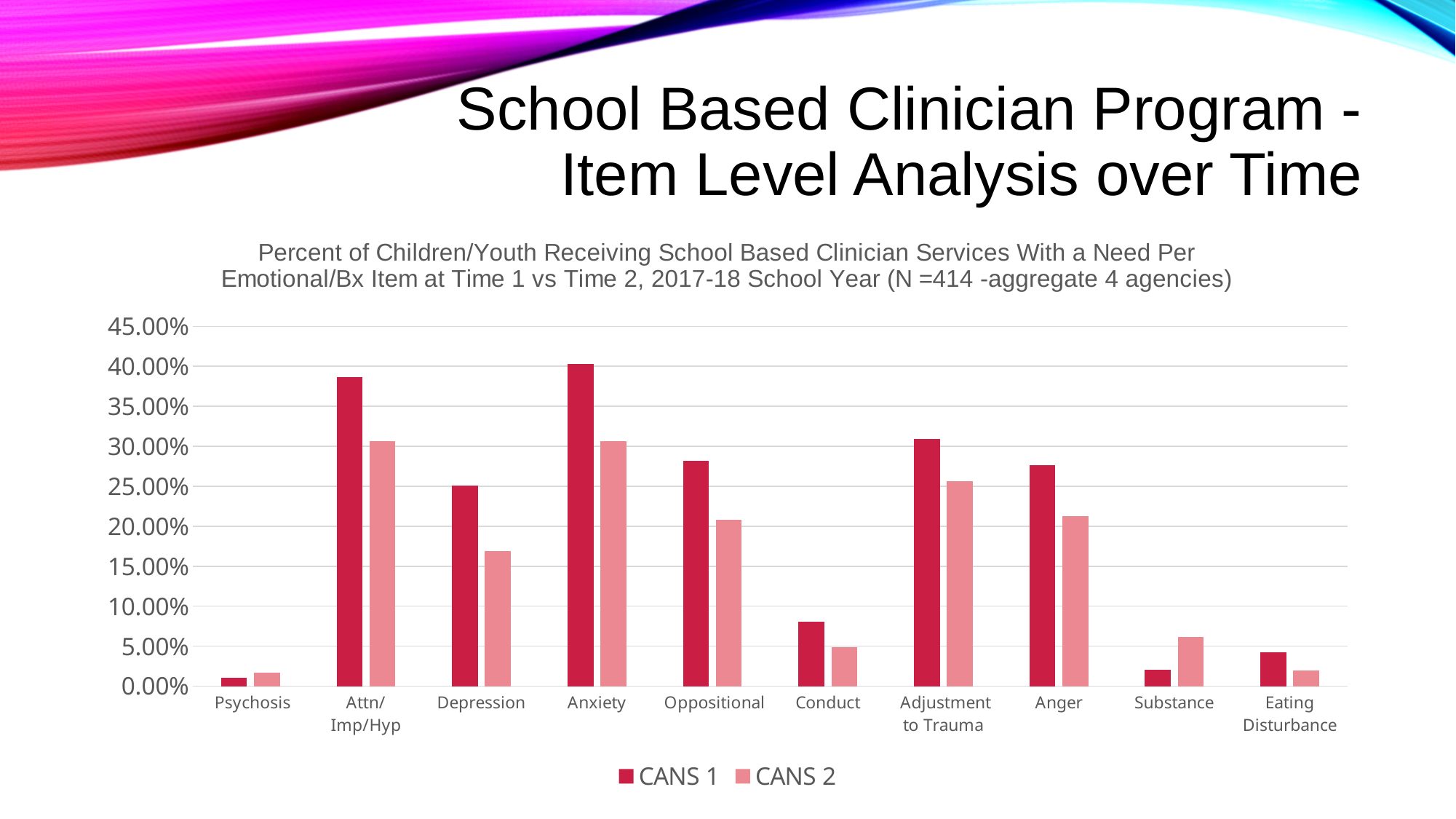
For Depression, which series has the larger value, CANS 1 or CANS 2? CANS 1 For Substance, which series has the larger value, CANS 1 or CANS 2? CANS 2 Is the CANS 1 value for Anxiety greater or less than 35.00%? greater How many categories are shown on the x axis? 10 Is the CANS 2 value for Substance greater or less than 5.00%? greater What kind of chart is shown on the slide? bar chart What are the two series named in the legend? CANS 1 and CANS 2 Is the CANS 1 value for Adjustment to Trauma greater or less than 25.00%? greater Which category has the lowest CANS 1 value? Psychosis How many series does the legend list? 2 Which category has the highest CANS 1 value? Anxiety